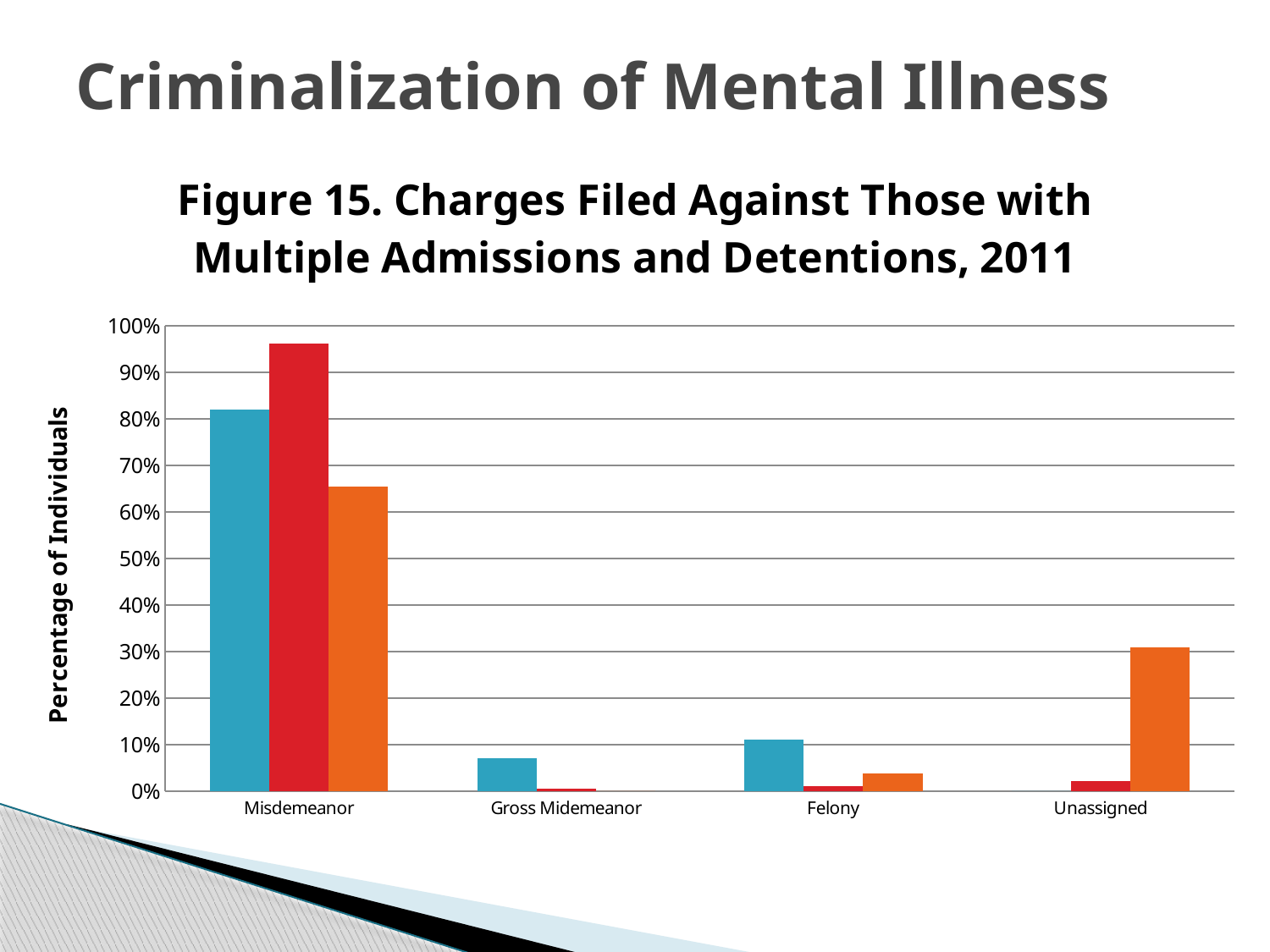
Is the value of the orange bar for Unassigned greater or less than 40%? less For the Unassigned category, which is larger: the orange bar or the red bar? the orange bar Is the value of the orange bar for Misdemeanor greater or less than 70%? less For the Misdemeanor category, which is larger: the red bar or the blue bar? the red bar What kind of chart is shown on the slide? bar chart Is the value of the blue bar for Gross Midemeanor greater or less than 10%? less How many bars are plotted for the Misdemeanor category? 3 How many charge categories are shown on the x axis? 4 What is the label on the vertical axis of the chart? Percentage of Individuals Which charge category has the tallest bars overall? Misdemeanor